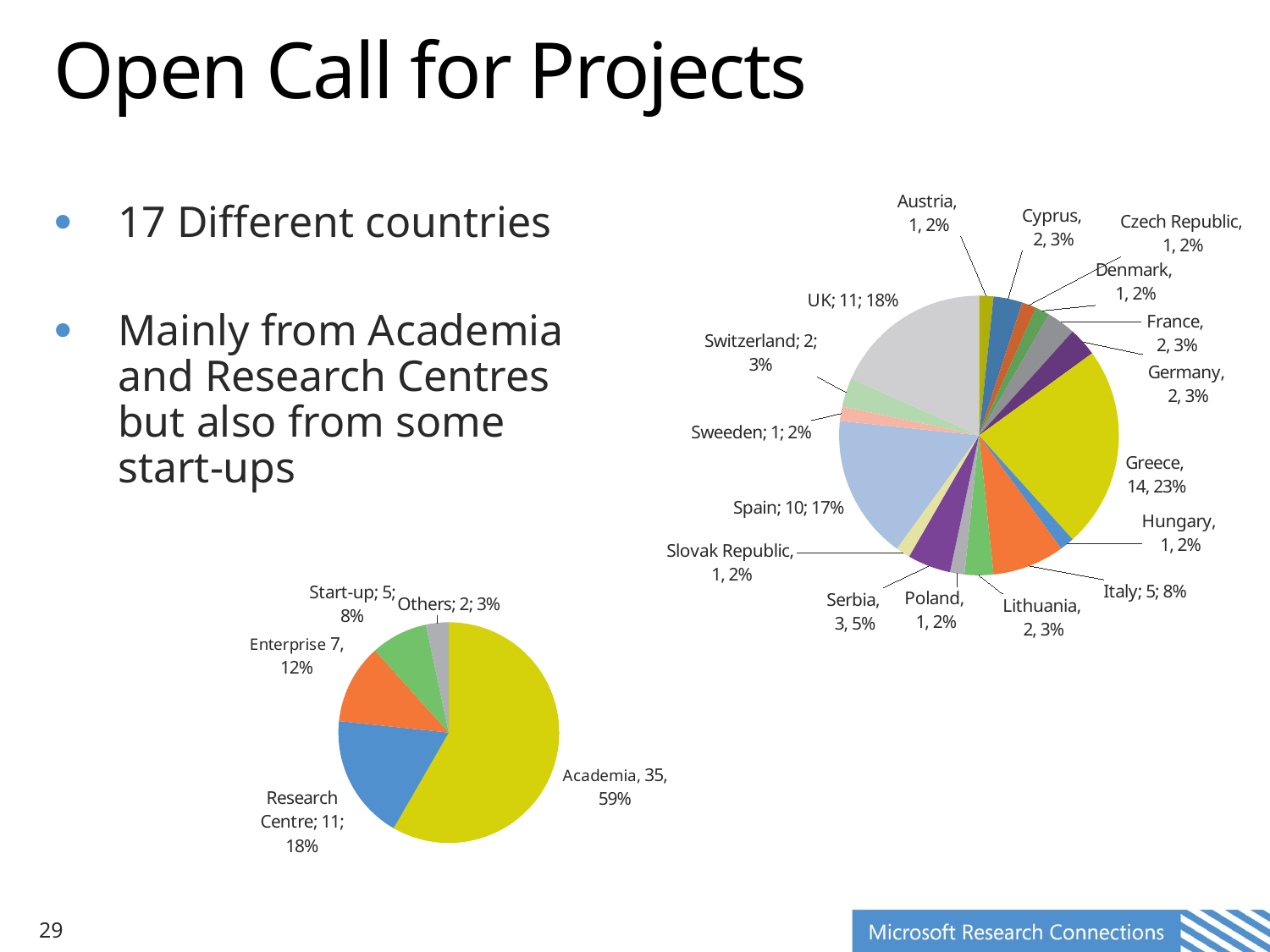
In the pie chart at the bottom left, what share of the pie does Research Centre represent? 18% How many countries are shown in the pie chart on the right? 17 In the pie chart on the right, how many projects are from Greece? 14 In the pie chart at the bottom left, how many projects are from Academia? 35 In the pie chart on the right, which has more projects, Serbia or Lithuania? Serbia In the pie chart at the bottom left, which category has the smallest slice? Others In the pie chart on the right, what share of the pie does Spain represent? 17% In the pie chart on the right, what is the difference between the number of projects from Greece and from Italy? 9 In the pie chart on the right, how many projects are from the UK? 11 What type of chart is shown at the bottom left of the slide? Pie chart In the pie chart on the right, which country has the largest slice? Greece In the pie chart at the bottom left, what is the difference between the number of Enterprise projects and Start-up projects? 2